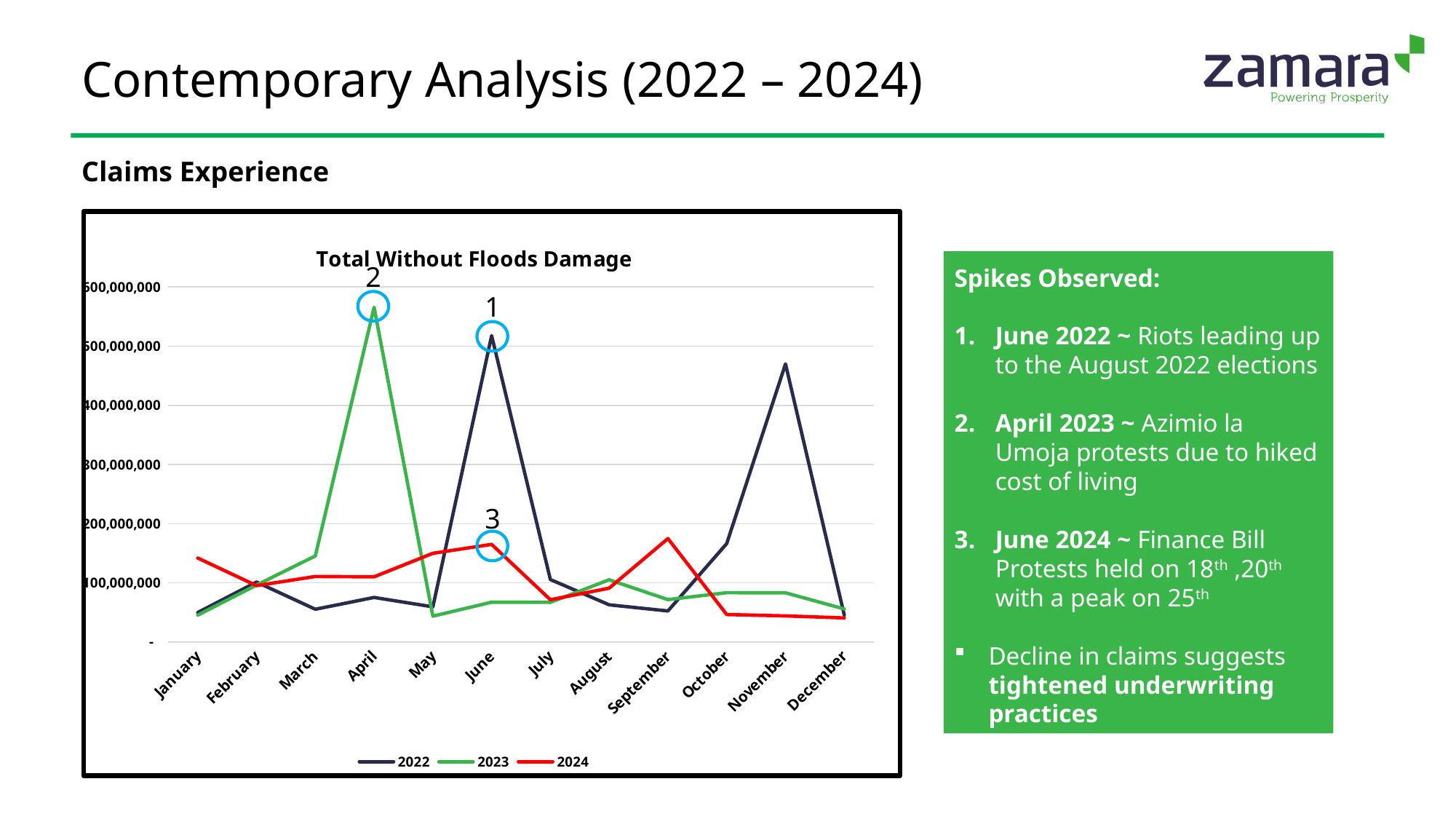
What type of chart is shown on the slide? Line chart Which series has the higher value in June, 2022 or 2024? 2022 How many months are shown along the x axis of the chart? 12 Is the value for 2024 in June greater or less than 200,000,000? less What is the title of the chart? Total Without Floods Damage Which series has the higher value in April, 2022 or 2023? 2023 In which month does the 2023 series reach its highest value? April Does the 2022 series rise or fall from November to December? Fall How many series does the chart's legend list? 3 Is the value for 2023 in April greater or less than 500,000,000? greater In which month does the 2022 series reach its highest value? June Is the value for 2022 in June greater or less than 400,000,000? greater